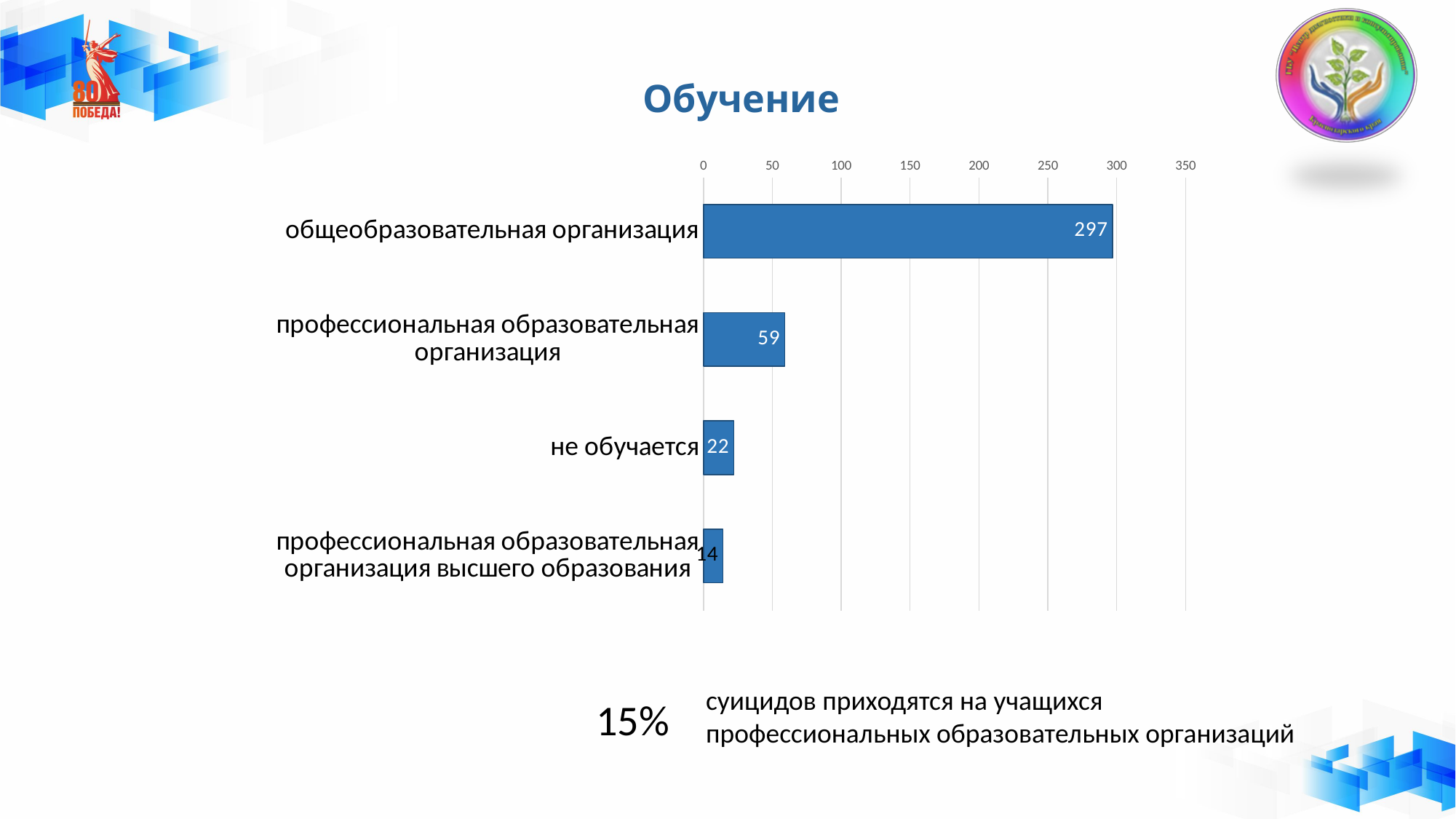
Which category has the highest value? общеобразовательная организация What is the value for профессиональная образовательная организация? 59 What is the value for не обучается? 22 What is the value for общеобразовательная организация? 297 Which category has the lowest value? профессиональная образовательная организация высшего образования How many categories are shown in the chart? 4 What is the value for профессиональная образовательная организация высшего образования? 14 Is the value for общеобразовательная организация greater or less than 250? greater What is the difference between the values for общеобразовательная организация and профессиональная образовательная организация? 238 Which is larger: the value for профессиональная образовательная организация or the value for не обучается? профессиональная образовательная организация What is the difference between the values for не обучается and профессиональная образовательная организация высшего образования? 8 What kind of chart is shown on the slide? bar chart